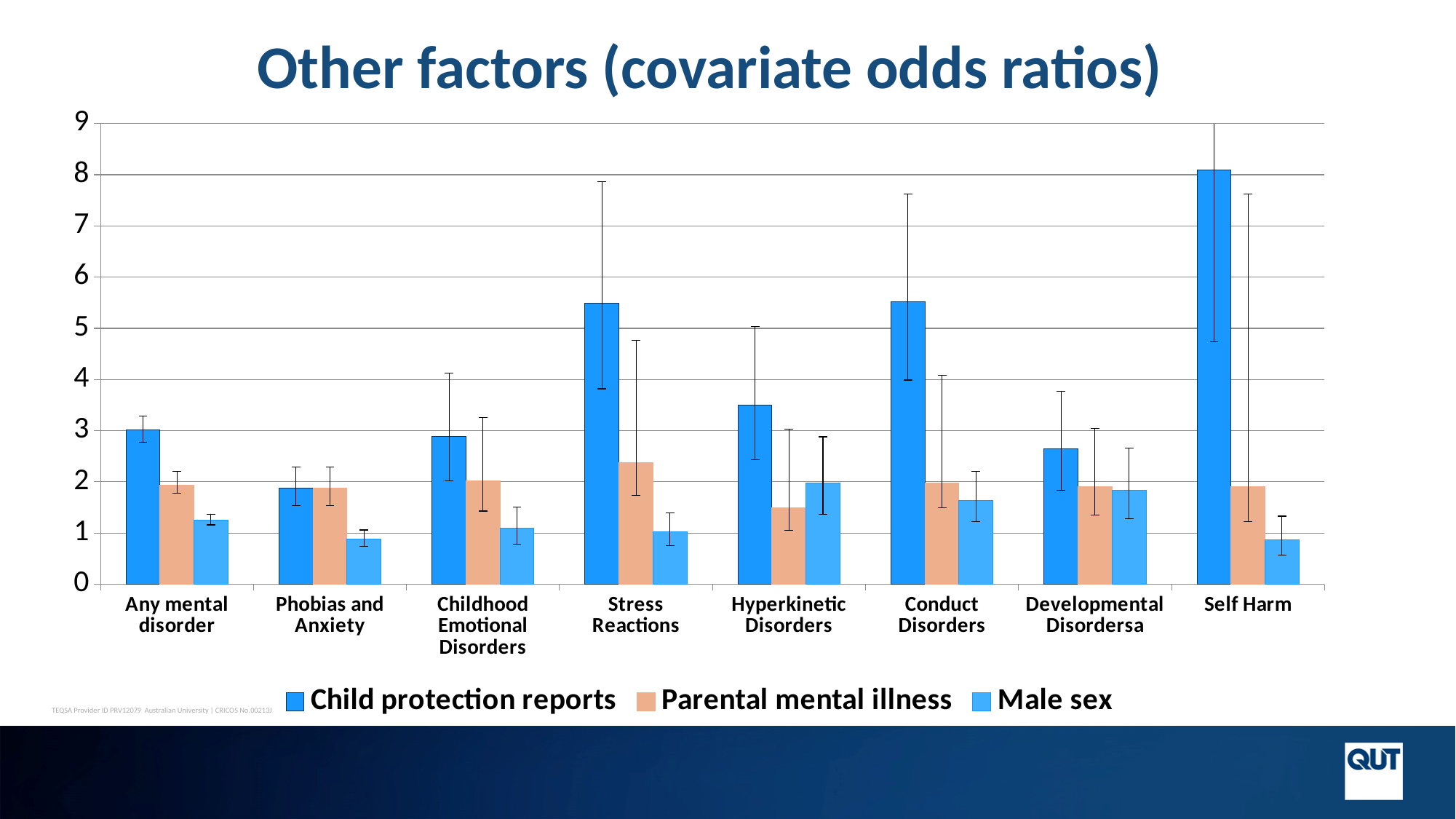
Is the Child protection reports value for Any mental disorder greater or less than 2? greater What kind of chart is shown on the slide? Bar chart Is the Child protection reports value for Stress Reactions greater or less than 5? greater Which category has the highest value for Parental mental illness? Stress Reactions How many series does the legend list? 3 How many categories are shown along the x axis? 8 For Hyperkinetic Disorders, which is larger: Male sex or Parental mental illness? Male sex Is the Male sex value for Hyperkinetic Disorders greater or less than 1? greater What is the title of the chart? Other factors (covariate odds ratios) For Stress Reactions, which is larger: Child protection reports or Parental mental illness? Child protection reports Which category has the highest value for Child protection reports? Self Harm